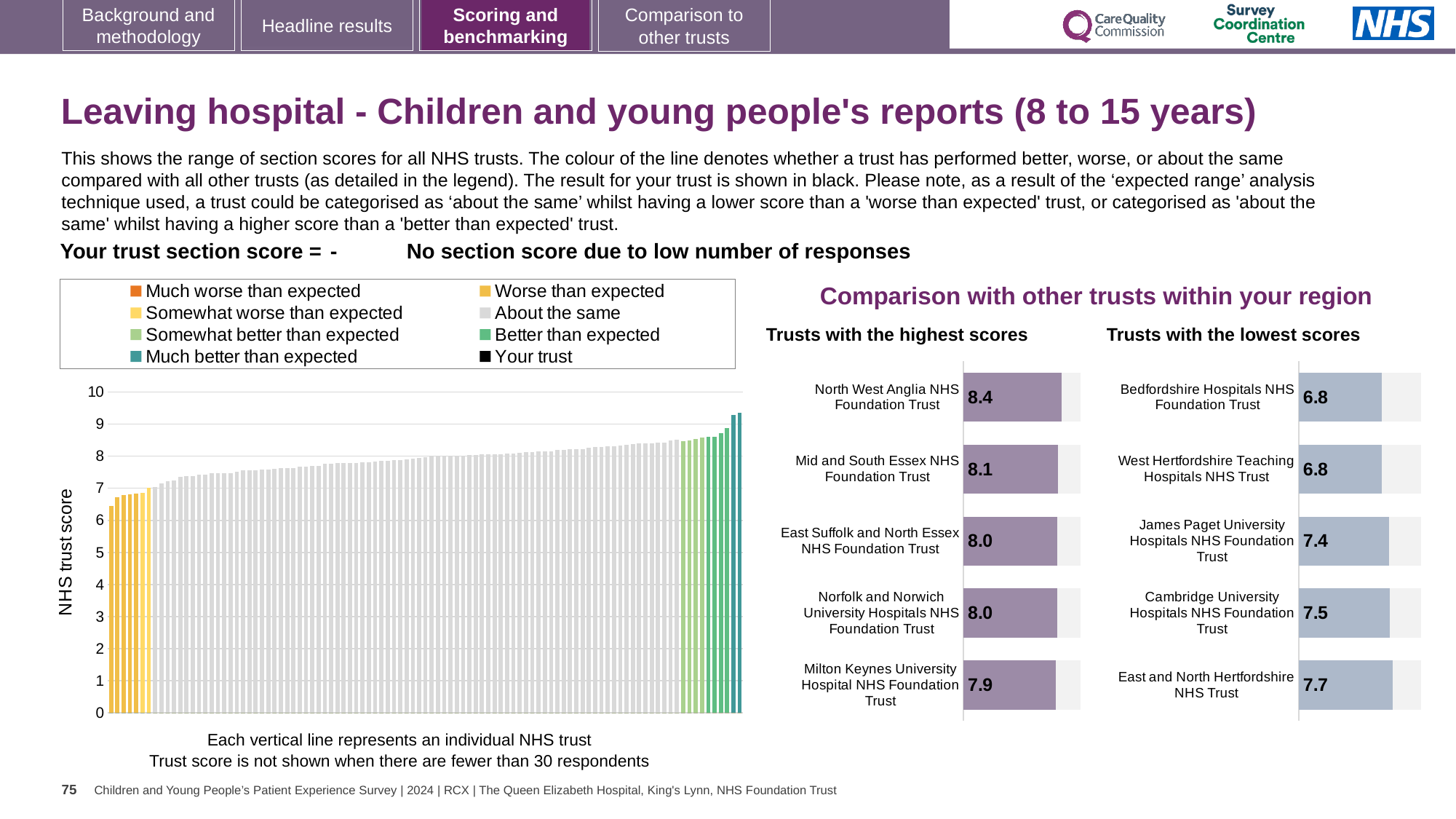
In the 'Trusts with the highest scores' chart, what is the score for North West Anglia NHS Foundation Trust? 8.4 In the 'Trusts with the lowest scores' chart, which has the larger score: Cambridge University Hospitals NHS Foundation Trust or James Paget University Hospitals NHS Foundation Trust? Cambridge University Hospitals NHS Foundation Trust In the 'Trusts with the lowest scores' chart, what is the difference between the scores of East and North Hertfordshire NHS Trust and Bedfordshire Hospitals NHS Foundation Trust? 0.9 In the 'Trusts with the highest scores' chart, what is the difference between the scores of North West Anglia NHS Foundation Trust and Milton Keynes University Hospital NHS Foundation Trust? 0.5 In the large chart on the left showing all NHS trusts, do the bar values rise or fall from left to right? rise How many entries does the legend above the large chart on the left list? 8 In the large chart on the left showing all NHS trusts, is the value of the shortest bar greater or less than 7? less How many trusts are listed in the 'Trusts with the highest scores' chart? 5 In the 'Trusts with the lowest scores' chart, which trust has the highest score shown? East and North Hertfordshire NHS Trust In the 'Trusts with the highest scores' chart, which trust has the highest score? North West Anglia NHS Foundation Trust In the 'Trusts with the lowest scores' chart, what is the score for James Paget University Hospitals NHS Foundation Trust? 7.4 In the large chart on the left showing all NHS trusts, is the value of the tallest bar greater or less than 9? greater